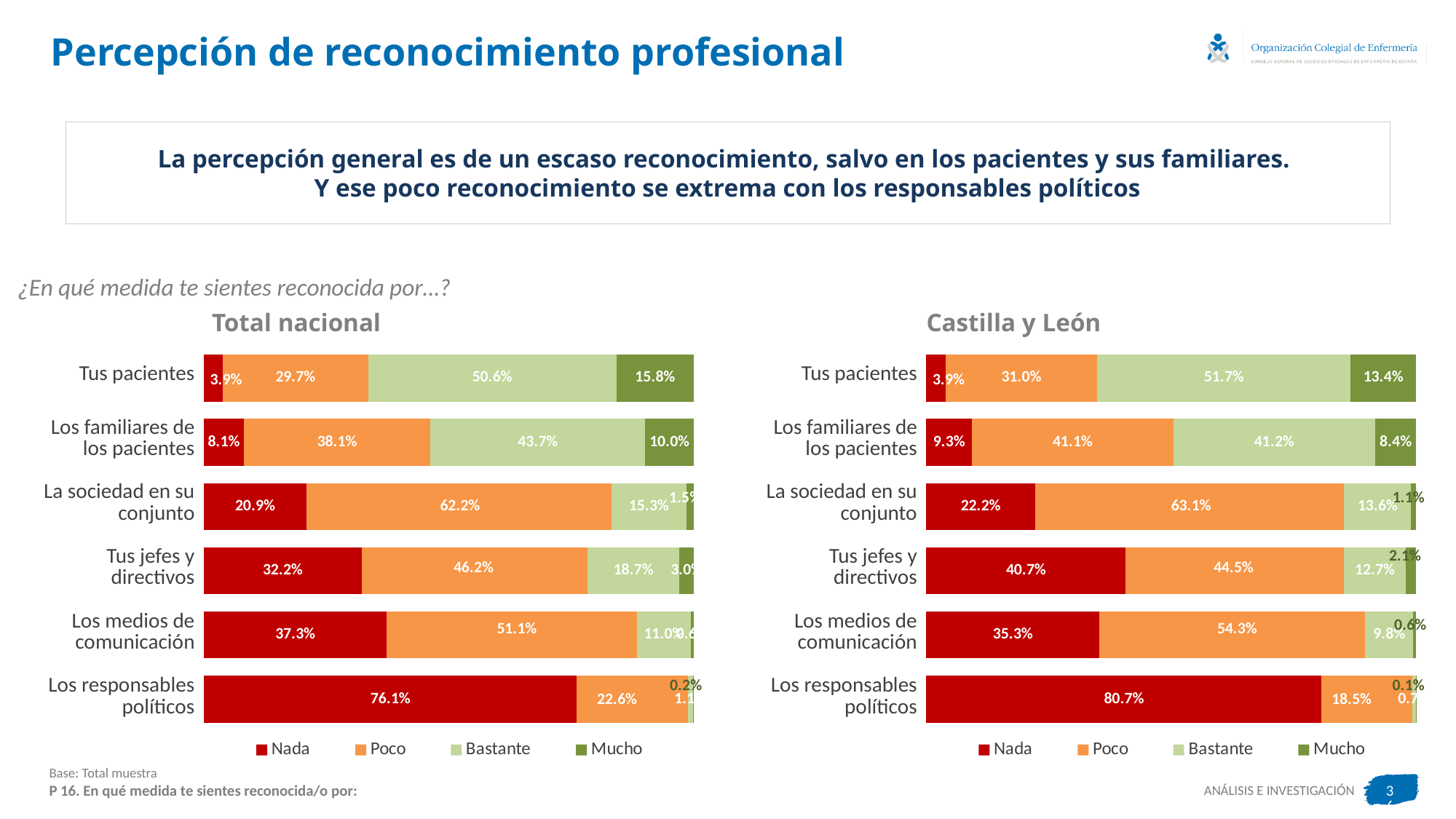
How many series does the legend of the Total nacional chart list? 4 In the Total nacional chart, what is the Nada value for Los responsables políticos? 76.1% How many categories are shown in the Castilla y León chart? 6 In the Total nacional chart, which category has the lowest Nada value? Tus pacientes In the Total nacional chart, what is the difference between the Poco values for La sociedad en su conjunto and Tus jefes y directivos? 16.0% What type of chart is the Total nacional chart? Stacked bar chart In the Total nacional chart, what is the Bastante value for Tus pacientes? 50.6% In the Castilla y León chart, what is the Mucho value for Tus pacientes? 13.4% In the Total nacional chart, which colour represents the Nada series? Red In the Castilla y León chart, what is the Poco value for Los medios de comunicación? 54.3% In the Castilla y León chart, which category has the highest Nada value? Los responsables políticos Is the Nada value for Tus jefes y directivos larger in the Total nacional chart or in the Castilla y León chart? Castilla y León